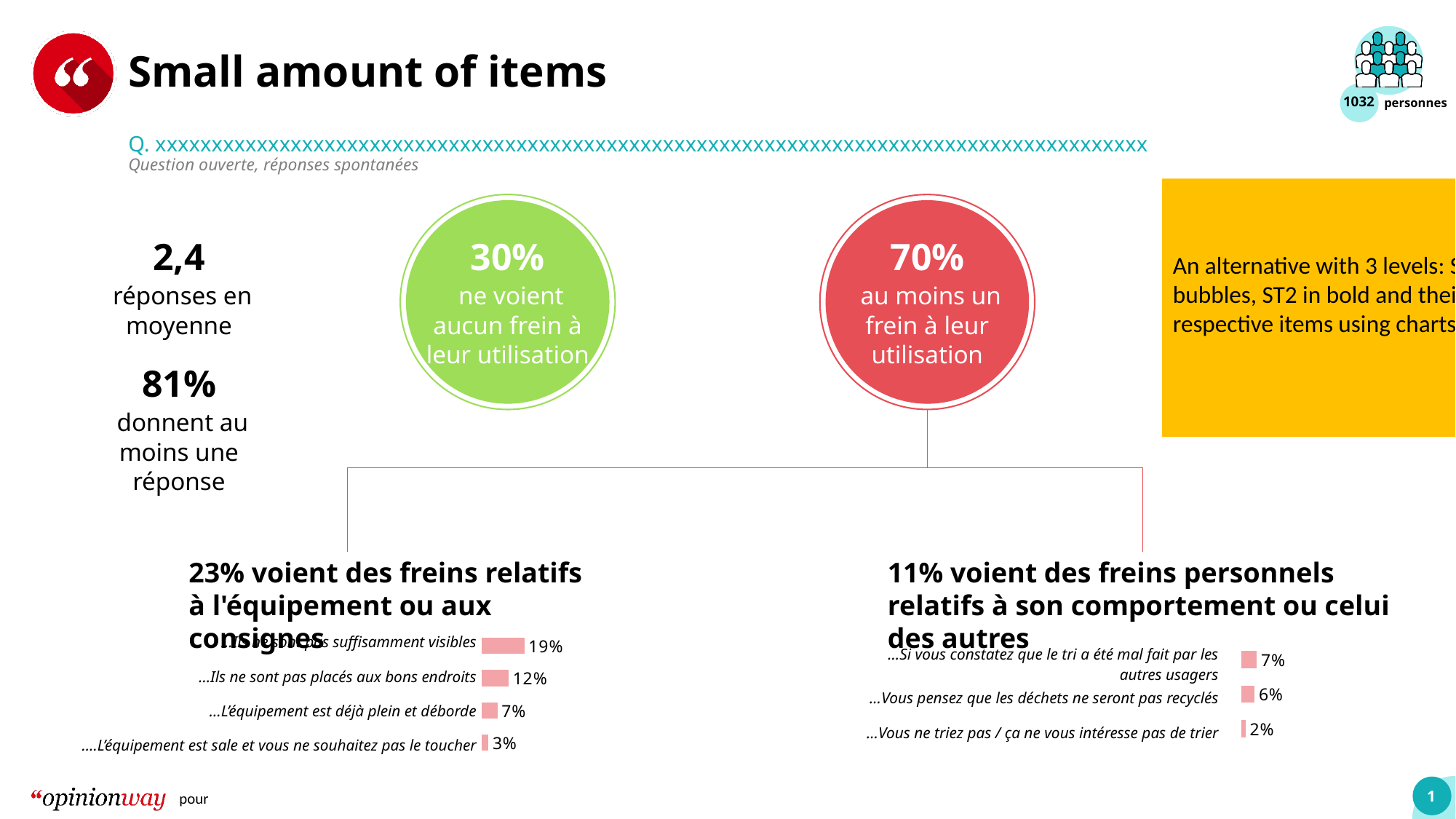
In the left chart, what is the difference between "Ils ne sont pas placés aux bons endroits" and "L'équipement est déjà plein et déborde"? 5 percentage points How many bars are in the right chart? 3 In the left chart, what is the highest value shown? 19% In the left chart (freins relatifs à l'équipement ou aux consignes), what is the value for "Ils ne sont pas placés aux bons endroits"? 12% In the left chart, which category has the lowest value? L'équipement est sale et vous ne souhaitez pas le toucher In the right chart, what is the value for "Vous ne triez pas / ça ne vous intéresse pas de trier"? 2% In the left chart, what is the value for "L'équipement est déjà plein et déborde"? 7% In the right chart, which is larger: "Vous pensez que les déchets ne seront pas recyclés" or "Vous ne triez pas / ça ne vous intéresse pas de trier"? Vous pensez que les déchets ne seront pas recyclés In the left chart, what is the value for "L'équipement est sale et vous ne souhaitez pas le toucher"? 3% How many bars are in the left chart? 4 In the right chart (freins personnels), what is the value for "Si vous constatez que le tri a été mal fait par les autres usagers"? 7% What type of chart is used on the right side of the slide? Bar chart